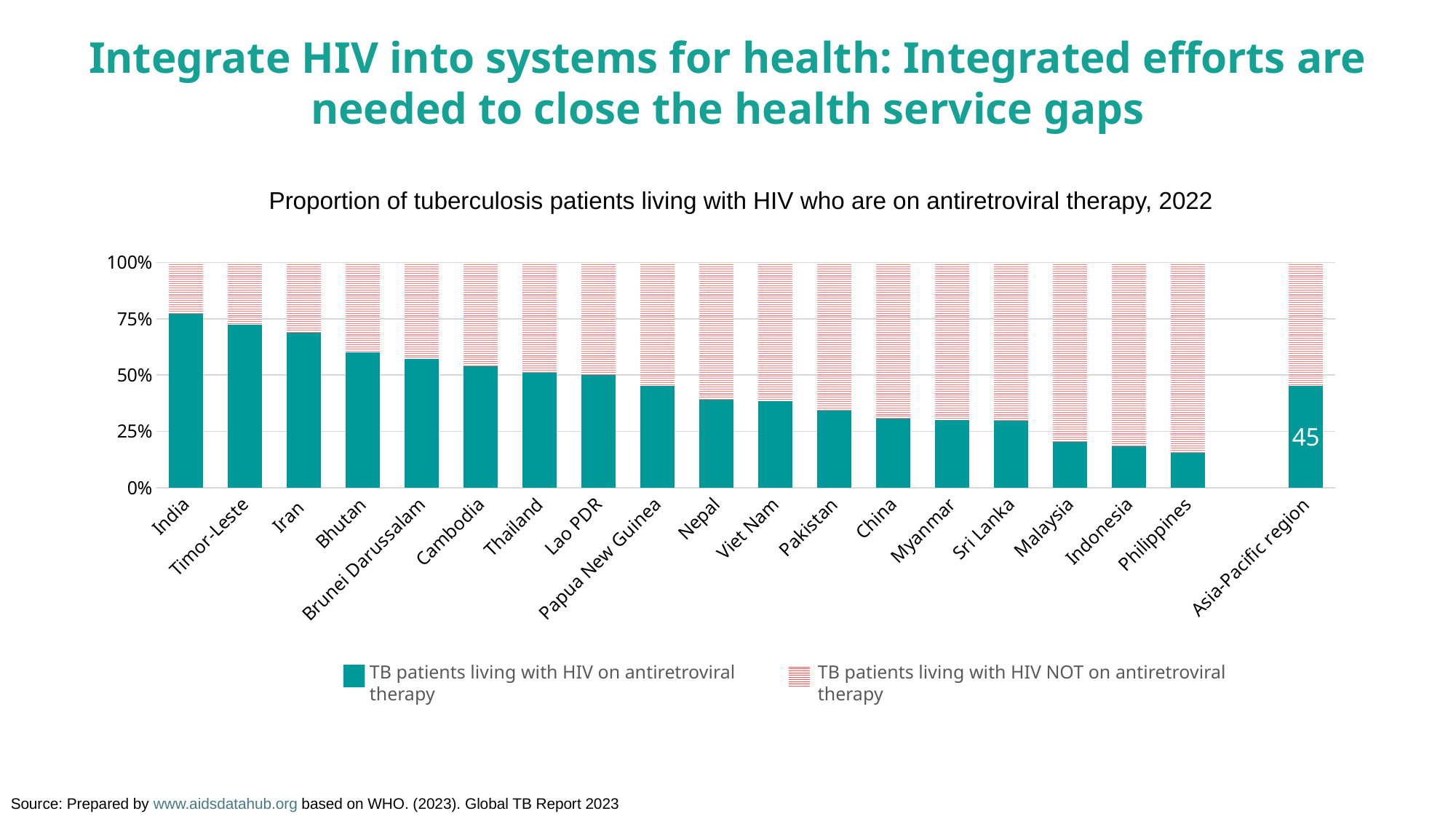
Which category has the lowest proportion of TB patients living with HIV on antiretroviral therapy? Philippines How many series does the legend list? 2 Is the proportion of TB patients living with HIV on antiretroviral therapy for Malaysia greater or less than 25%? less Which has a larger proportion of TB patients living with HIV on antiretroviral therapy, Cambodia or Indonesia? Cambodia How many categories are shown on the x axis of the chart? 19 What value is labelled on the bar for the Asia-Pacific region? 45 Do the proportions of TB patients living with HIV on antiretroviral therapy rise or fall from India to Philippines along the x axis? Fall Which category has the highest proportion of TB patients living with HIV on antiretroviral therapy? India Is the proportion of TB patients living with HIV on antiretroviral therapy for Timor-Leste greater or less than 50%? greater What kind of chart is shown on the slide? Stacked bar chart What is the title of the chart? Proportion of tuberculosis patients living with HIV who are on antiretroviral therapy, 2022 Is the proportion of TB patients living with HIV on antiretroviral therapy for Bhutan greater or less than 50%? greater